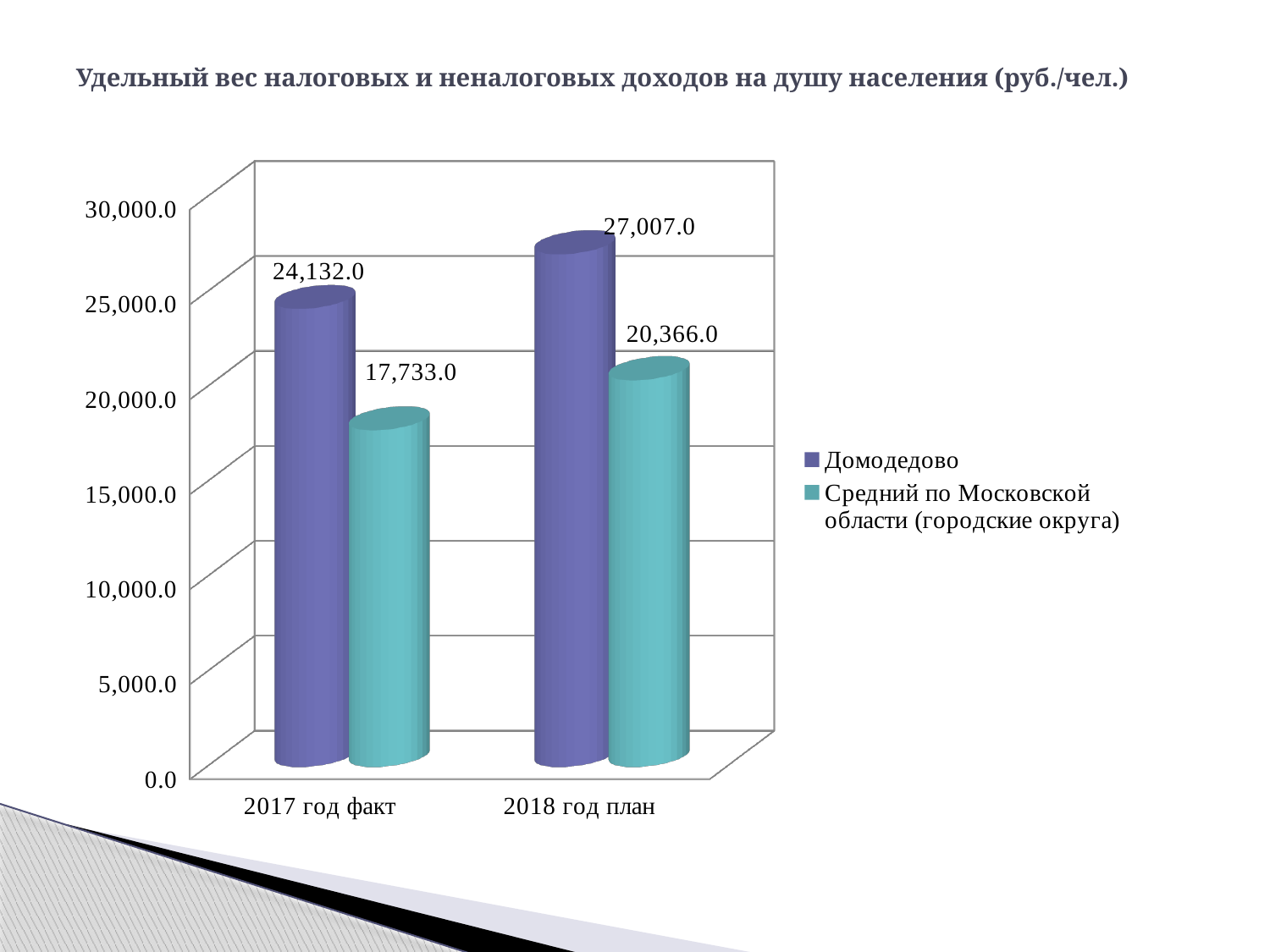
Which is larger in 2017 год факт: Домодедово or Средний по Московской области (городские округа)? Домодедово Which category has the highest value for Домодедово? 2018 год план Which series has the lowest value in 2017 год факт? Средний по Московской области (городские округа) How many series does the legend list? 2 What is the value for Средний по Московской области (городские округа) in 2017 год факт? 17,733.0 What is the difference between Домодедово and Средний по Московской области (городские округа) in 2018 год план? 6,641.0 What is the value for Средний по Московской области (городские округа) in 2018 год план? 20,366.0 What is the value for Домодедово in 2018 год план? 27,007.0 What kind of chart is shown on the slide? Bar chart How many categories are shown on the x axis? 2 What is the value for Домодедово in 2017 год факт? 24,132.0 What is the difference between the Домодедово values for 2018 год план and 2017 год факт? 2,875.0